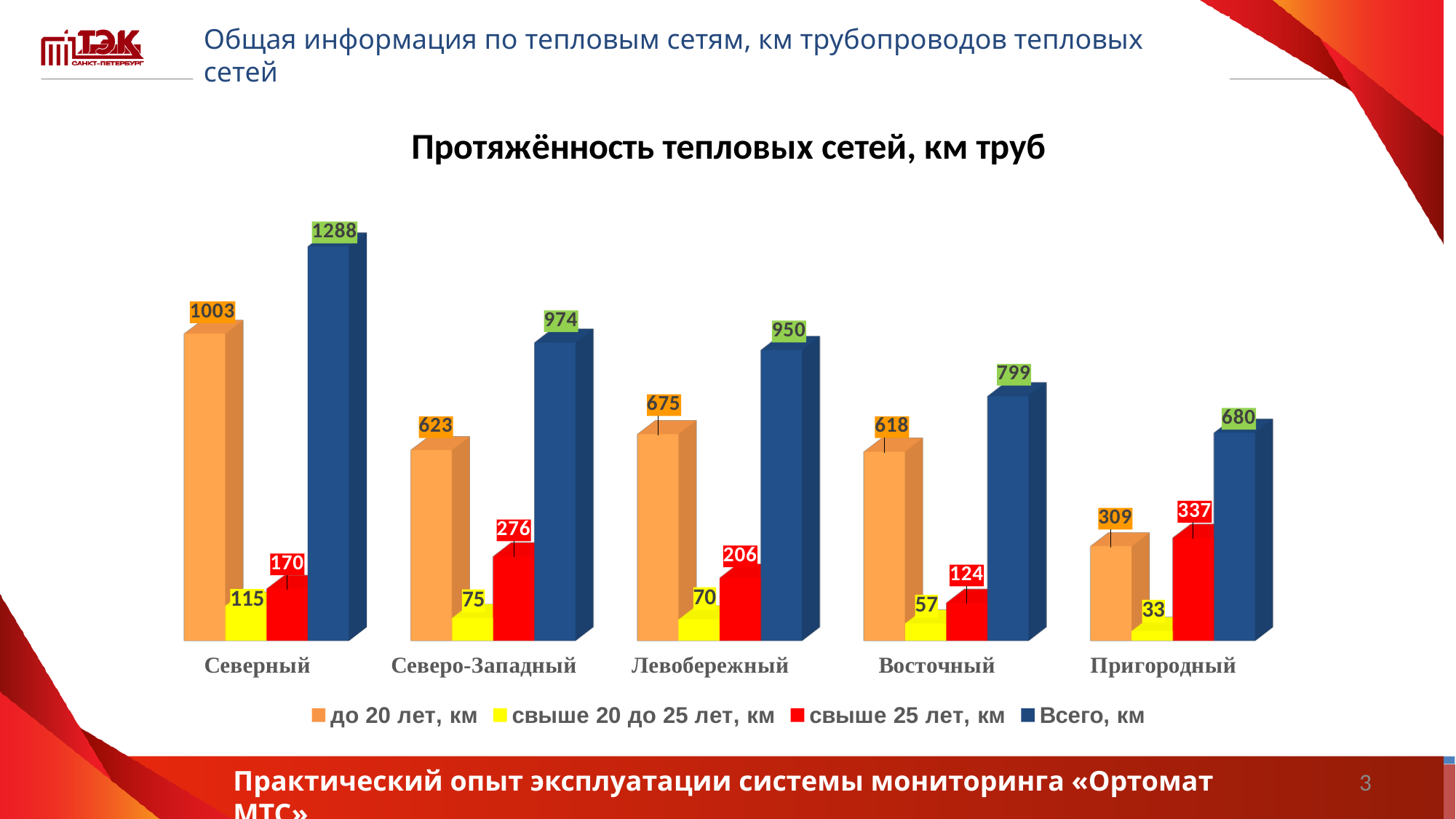
What is the value of "свыше 25 лет, км" for Пригородный? 337 What is the value of "Всего, км" for Северный? 1288 How many categories are shown on the x axis? 5 What kind of chart is shown on the slide? Bar chart What is the difference between the "Всего, км" values for Северо-Западный and Левобережный? 24 How many series does the legend list? 4 Which category has the highest value for "Всего, км"? Северный What is the value of "до 20 лет, км" for Левобережный? 675 Which is larger: the "свыше 25 лет, км" value for Северо-Западный or for Левобережный? Северо-Западный Which category has the lowest value for "свыше 20 до 25 лет, км"? Пригородный What is the title of the chart? Протяжённость тепловых сетей, км труб What is the value of "свыше 20 до 25 лет, км" for Восточный? 57